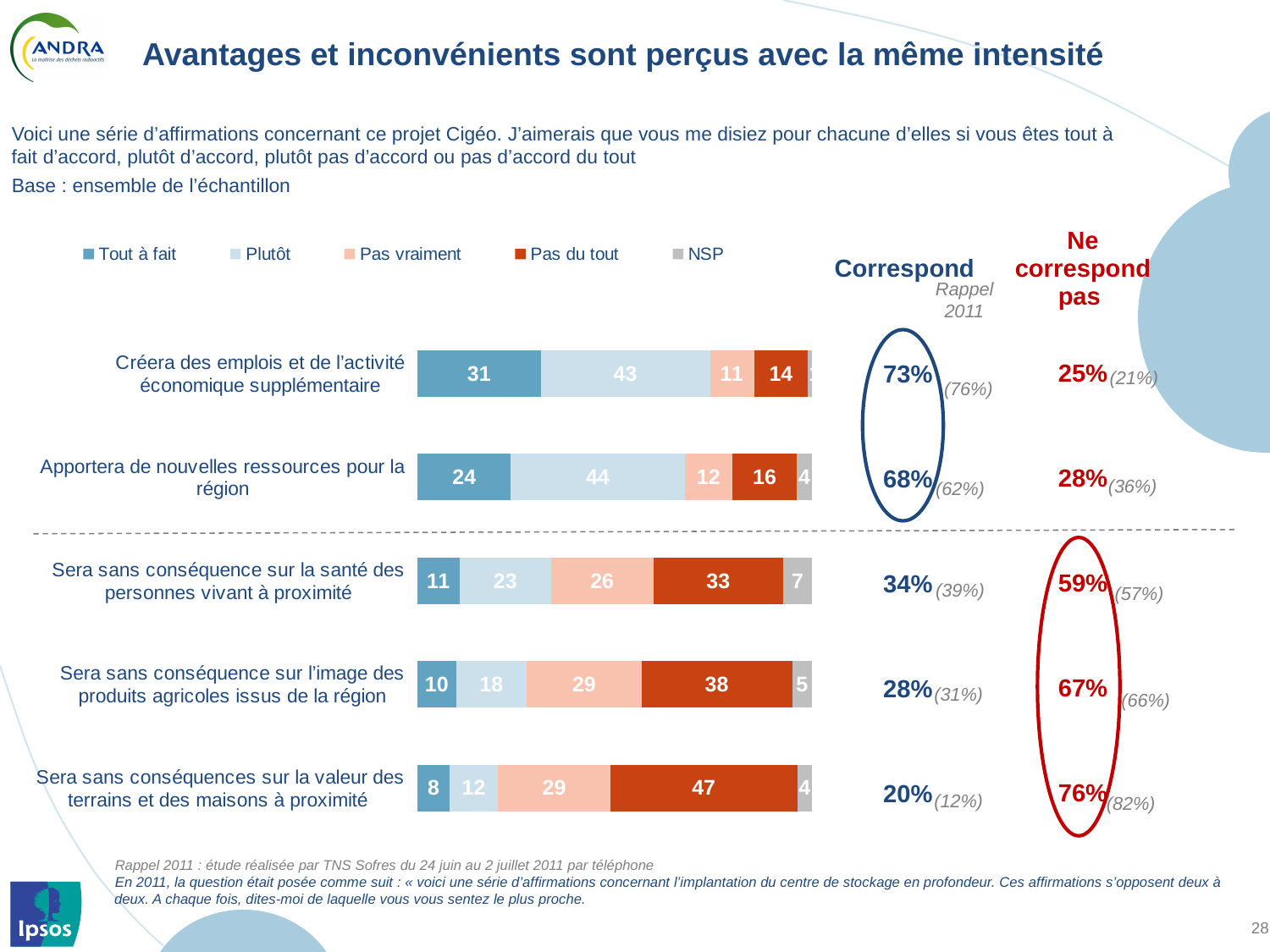
How many series does the legend list? 5 What is the difference between the 'Pas du tout' values for 'Sera sans conséquence sur l'image des produits agricoles issus de la région' and 'Sera sans conséquence sur la santé des personnes vivant à proximité'? 5 How many statements (categories) are plotted in the chart? 5 What is the NSP value for 'Sera sans conséquence sur la santé des personnes vivant à proximité'? 7 Which statement has the highest 'Pas du tout' value? Sera sans conséquences sur la valeur des terrains et des maisons à proximité What is the 'Pas du tout' value for 'Sera sans conséquences sur la valeur des terrains et des maisons à proximité'? 47 What is the 'Tout à fait' value for 'Créera des emplois et de l'activité économique supplémentaire'? 31 What is the total of the stacked bar for 'Apportera de nouvelles ressources pour la région'? 100 Which statement has the lowest 'Tout à fait' value? Sera sans conséquences sur la valeur des terrains et des maisons à proximité What kind of chart is shown on the slide? stacked bar chart What is the 'Plutôt' value for 'Apportera de nouvelles ressources pour la région'? 44 Which is larger: the 'Pas vraiment' value for 'Sera sans conséquence sur la santé des personnes vivant à proximité' or for 'Apportera de nouvelles ressources pour la région'? Sera sans conséquence sur la santé des personnes vivant à proximité